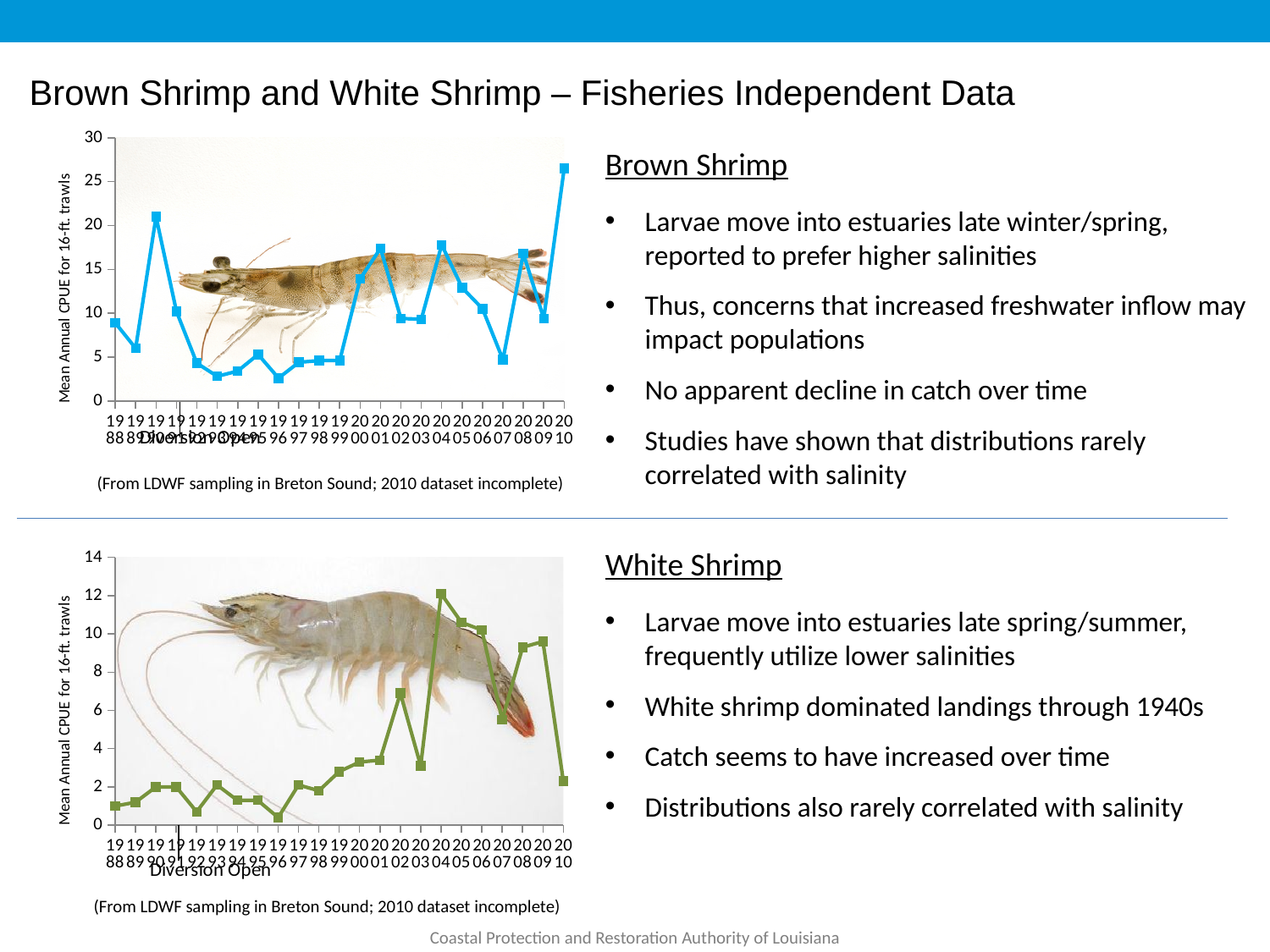
What is the y-axis label on the top chart (Brown Shrimp)? Mean Annual CPUE for 16-ft. trawls In the bottom chart (White Shrimp), which year has the highest mean annual CPUE? 2004 In the top chart (Brown Shrimp), is the value for 1990 greater or less than 20? greater In the top chart (Brown Shrimp), which year has the highest mean annual CPUE? 2010 In the top chart (Brown Shrimp), which year has the larger value, 1988 or 1990? 1990 In the bottom chart (White Shrimp), is the value for 1988 greater or less than 2? less What kind of chart is the top chart (Brown Shrimp)? line chart What kind of chart is the bottom chart (White Shrimp)? line chart In the bottom chart (White Shrimp), do the values generally rise or fall from 1988 to 2009? rise In the bottom chart (White Shrimp), is the value for 2009 greater or less than 8? greater In the bottom chart (White Shrimp), which year has the larger value, 2004 or 2010? 2004